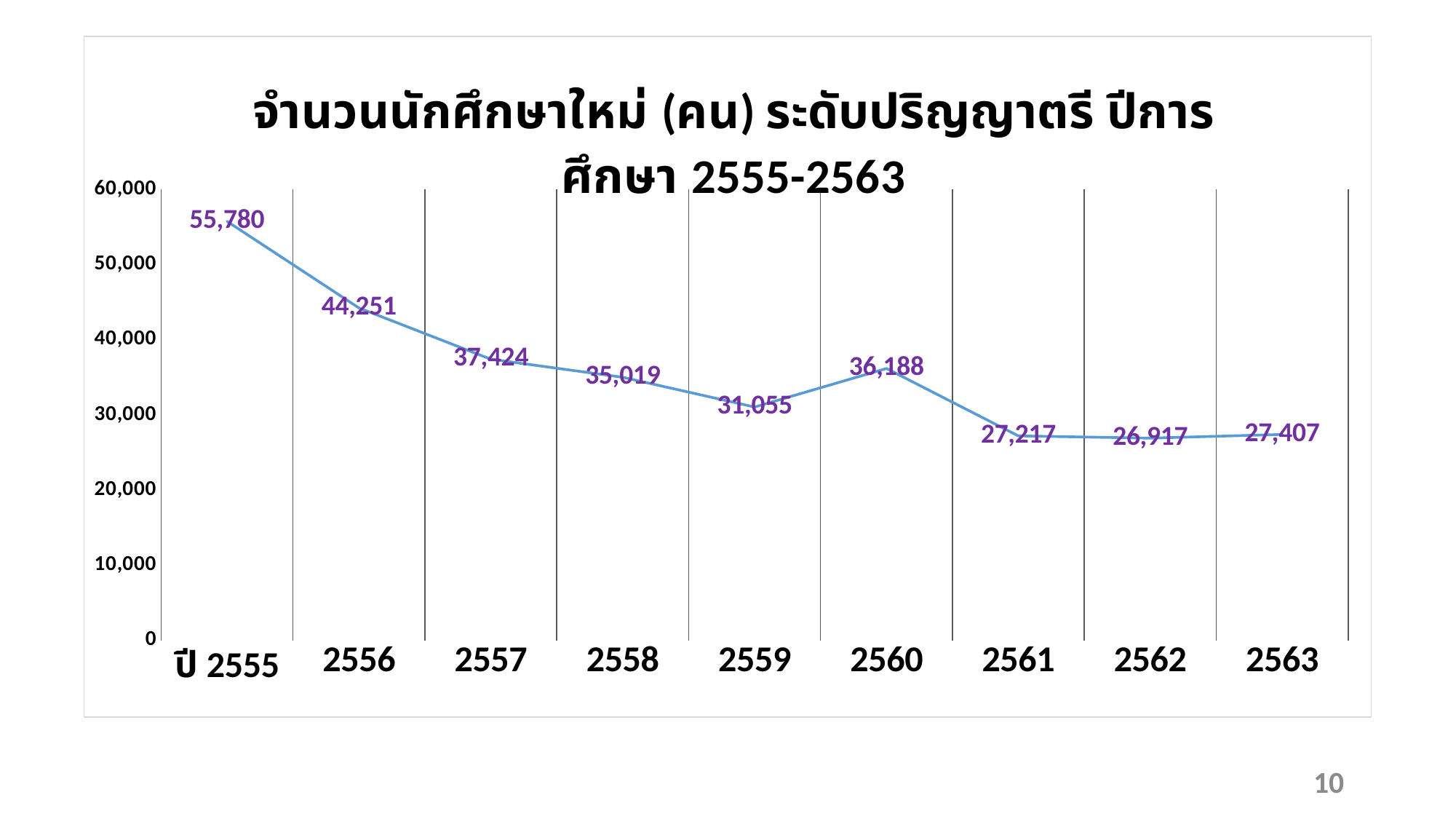
How many years are plotted on the chart? 9 What is the difference between the values for 2555 and 2556? 11,529 Do the values generally rise or fall from 2555 to 2563? fall What is the value plotted for year 2563? 27,407 What is the number of new undergraduate students in academic year 2555? 55,780 Which is larger, the value for 2559 or the value for 2560? 2560 What kind of chart is shown on the slide? line chart What is the difference between the values for 2560 and 2561? 8,971 Is the value for 2557 greater or less than 40,000? less Which year has the highest number of new students? 2555 Which year has the lowest number of new students? 2562 What is the value plotted for year 2560? 36,188